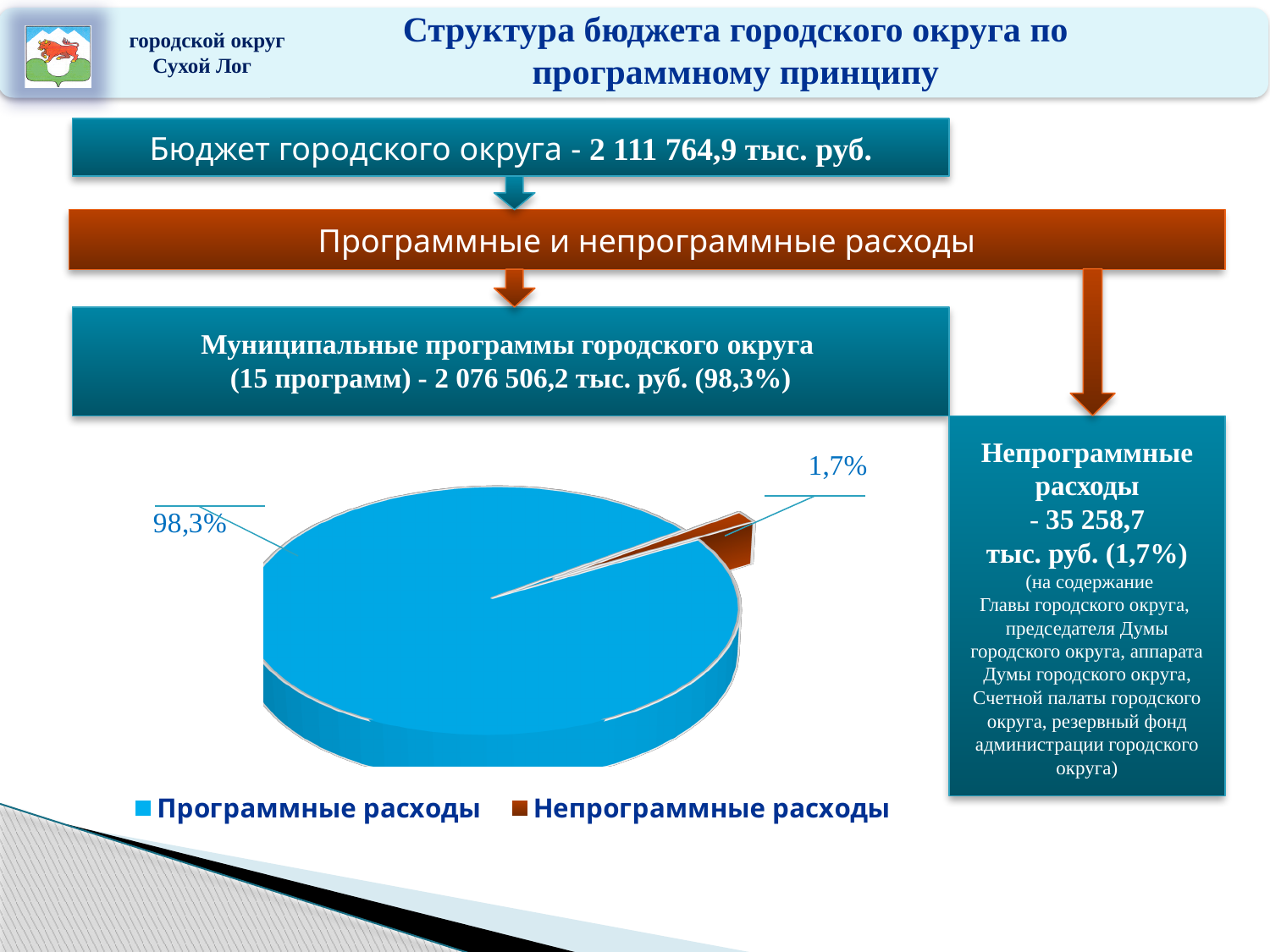
Which slice of the pie chart is the largest? Программные расходы Which is larger in the pie chart: "Программные расходы" or "Непрограммные расходы"? Программные расходы How many entries does the chart legend list? 2 Which slice of the pie chart is the smallest? Непрограммные расходы What share of the pie does "Программные расходы" take? 98,3% What share of the pie does "Непрограммные расходы" take? 1,7% What colour is the "Программные расходы" slice in the pie chart? blue How many slices does the pie chart have? 2 What is the difference in percentage points between the "Программные расходы" and "Непрограммные расходы" slices? 96,6 What kind of chart is shown on the slide? pie chart What colour is the "Непрограммные расходы" slice in the pie chart? brown (dark orange)